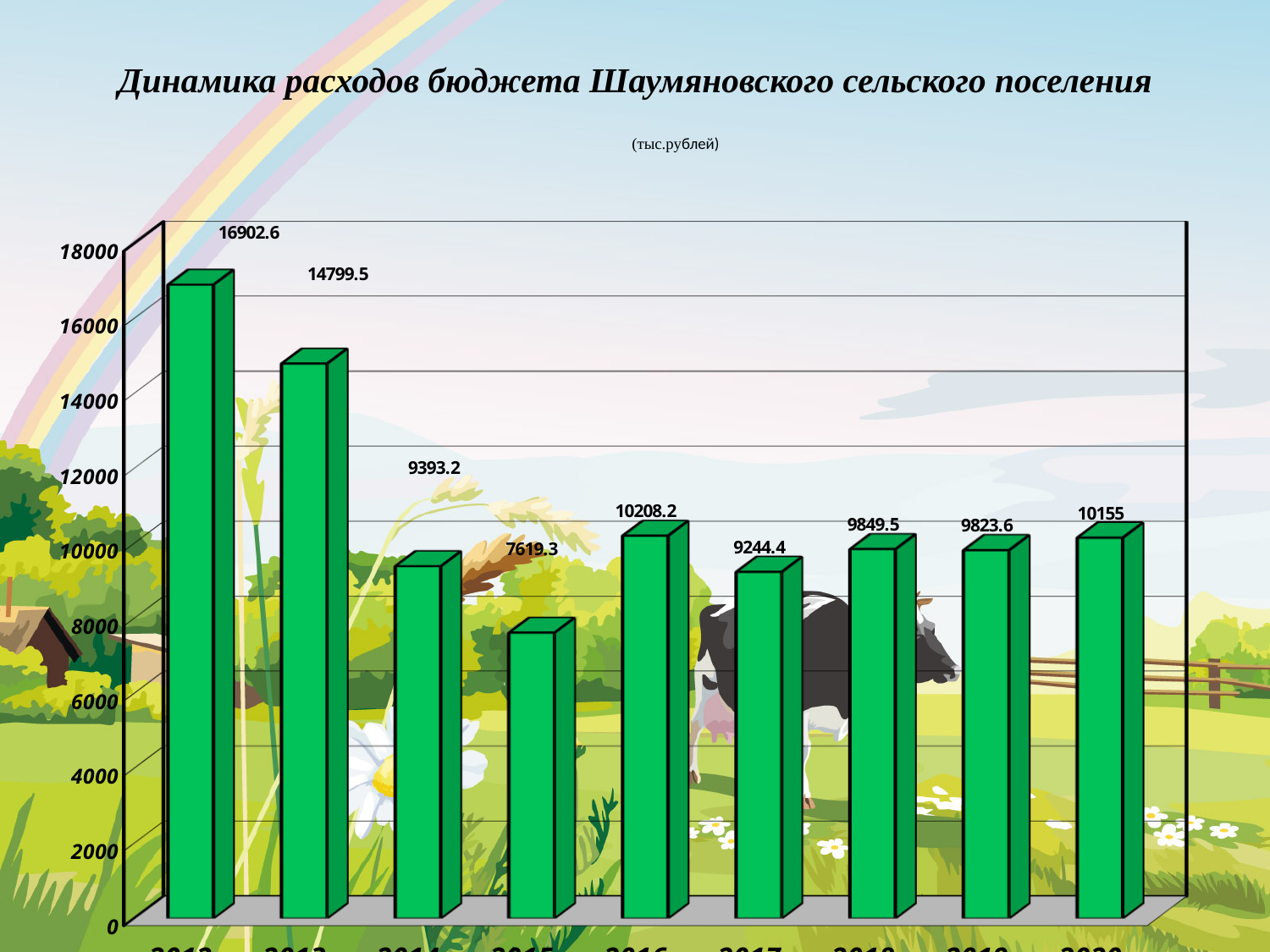
What is the difference between the first bar (16902.6) and the second bar (14799.5)? 2103.1 Is the value of the third bar greater or less than 10000? less Which bar has the lowest value? the fourth bar, 7619.3 What is the value of the first (leftmost) bar? 16902.6 How many bars are plotted in the chart? 9 What kind of chart is shown on the slide? bar chart Do the values rise or fall from the first bar to the fourth bar? fall What is the value of the last (rightmost) bar? 10155 In what units are the values given, according to the subtitle? тыс.рублей What is the value of the fifth bar from the left? 10208.2 Which is larger: the fifth bar or the last bar? the fifth bar (10208.2) Which bar has the highest value? the first (leftmost) bar, 16902.6